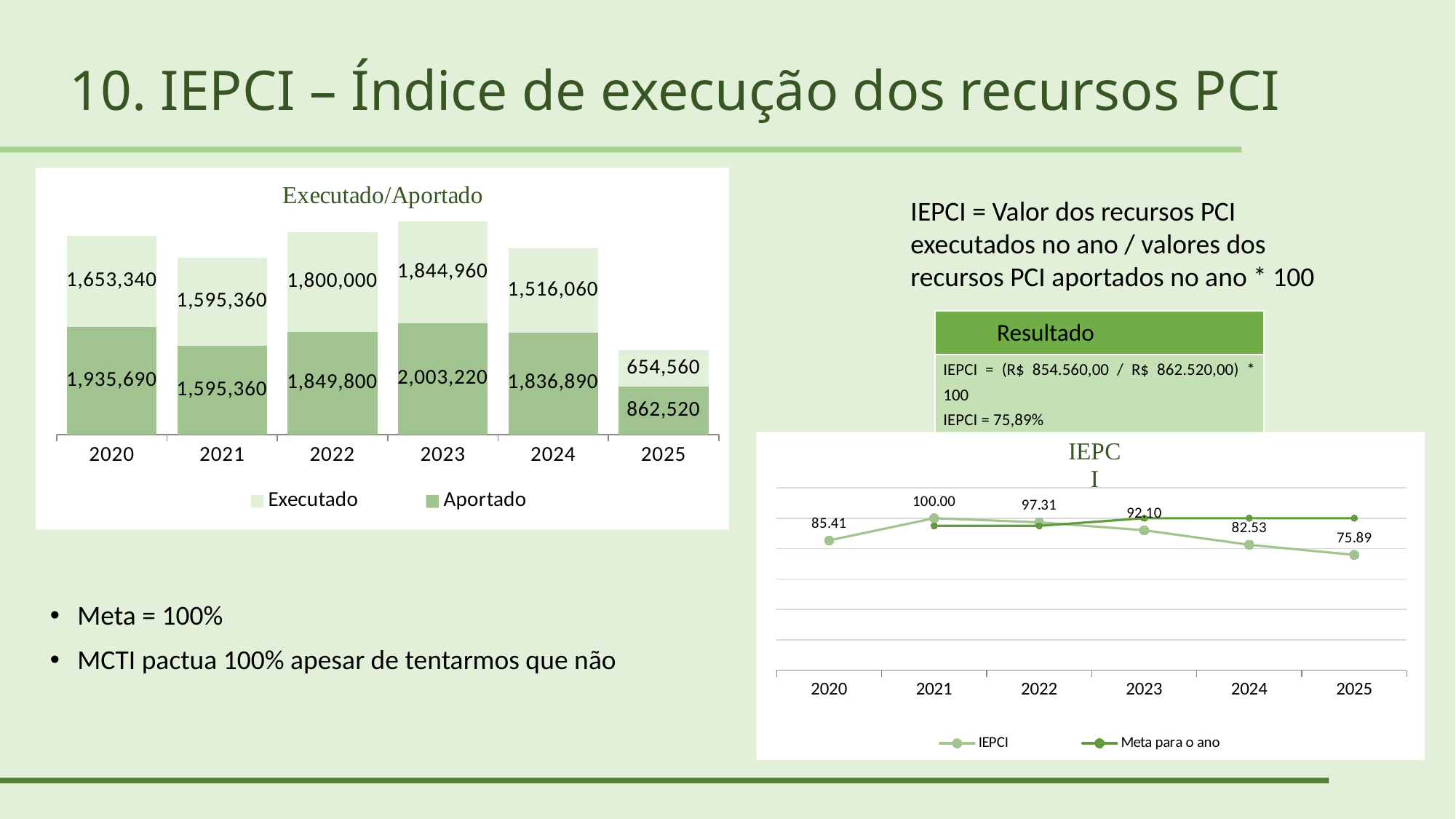
In the Executado/Aportado chart, how many series does the legend list? 2 In the Executado/Aportado chart, which year has the lowest Executado value? 2025 In the IEPCI chart, what is the IEPCI value for 2024? 82.53 In the Executado/Aportado chart, what is the difference between the Aportado and Executado values for 2020? 282,350 In the IEPCI chart, is the IEPCI value for 2022 larger or smaller than the value for 2023? larger In the Executado/Aportado chart, what is the total of the stacked bar for 2025? 1,517,080 In the IEPCI chart, does the IEPCI line rise or fall from 2021 to 2025? fall In the IEPCI chart, which year has the lowest IEPCI value? 2025 In the Executado/Aportado chart, what is the Aportado value for 2025? 862,520 In the Executado/Aportado chart, what is the Executado value for 2023? 1,844,960 What kind of chart is the Executado/Aportado chart? Stacked bar chart In the Executado/Aportado chart, which year has the highest Aportado value? 2023